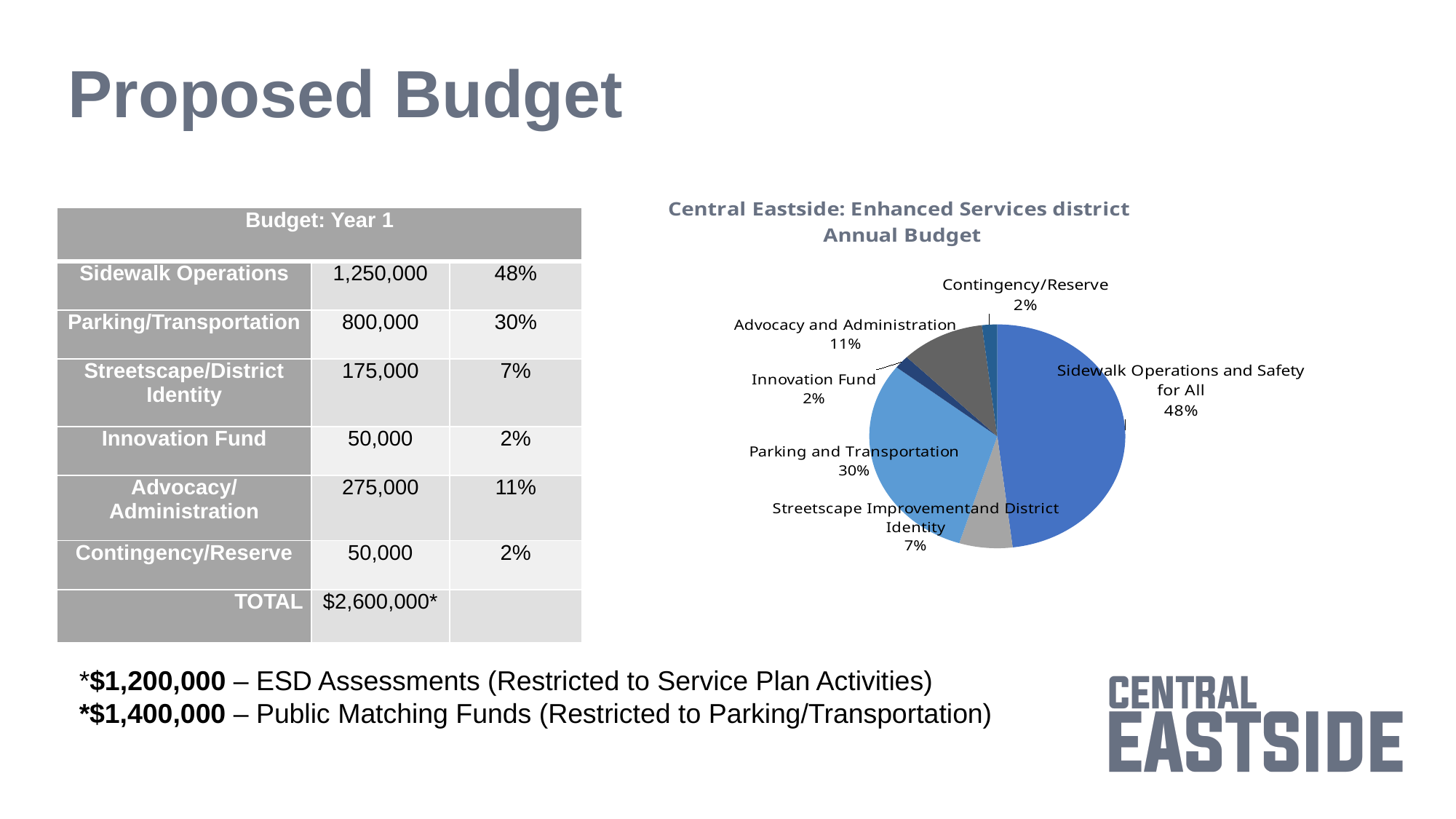
Which slice of the pie chart is the largest? Sidewalk Operations and Safety for All What share of the pie chart does Parking and Transportation represent? 30% What share of the pie chart does Advocacy and Administration represent? 11% What is the title of the pie chart? Central Eastside: Enhanced Services district Annual Budget How many slices does the pie chart have? 6 What share of the pie chart does Streetscape Improvement and District Identity represent? 7% What kind of chart is shown on the slide? pie chart What is the difference in percentage points between the Sidewalk Operations and Safety for All slice and the Parking and Transportation slice? 18% What is the difference in percentage points between the Advocacy and Administration slice and the Contingency/Reserve slice? 9% Which slice is larger in the pie chart: Advocacy and Administration or Streetscape Improvement and District Identity? Advocacy and Administration